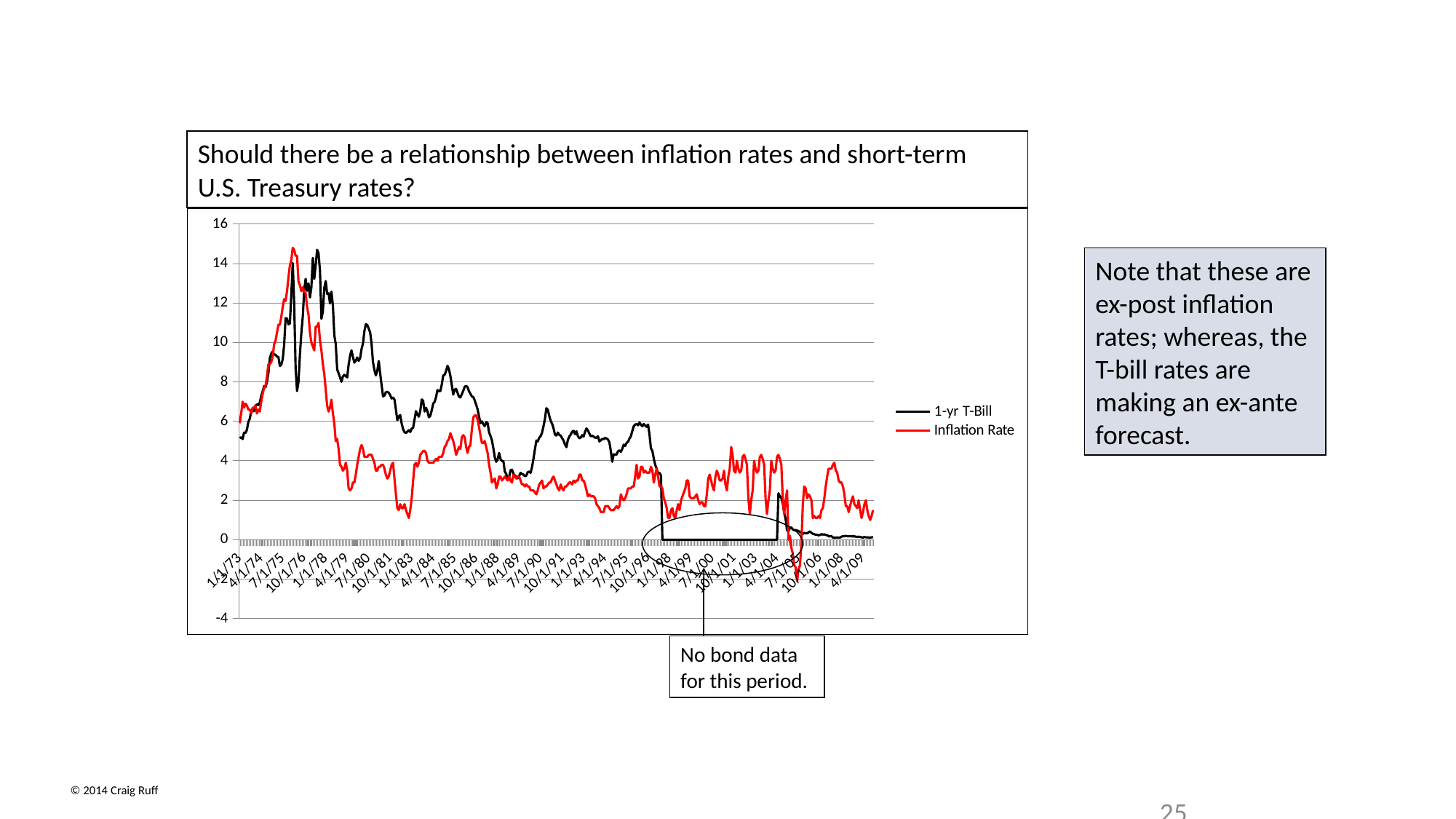
Which series is higher at 1/1/73, the 1-yr T-Bill or the Inflation Rate? Inflation Rate What kind of chart is shown on the slide? line chart Is the highest value reached by the Inflation Rate line greater or less than 12? greater Is the value of the Inflation Rate at 4/1/09 greater or less than 2? less What colour is the Inflation Rate line? red Is the value of the 1-yr T-Bill at 4/1/09 greater or less than 2? less Which series is higher around 1/1/85, the 1-yr T-Bill or the Inflation Rate? 1-yr T-Bill What are the two series named in the legend? 1-yr T-Bill and Inflation Rate How many series does the legend list? 2 Overall, does the 1-yr T-Bill line rise or fall from 1/1/73 to 4/1/09? fall